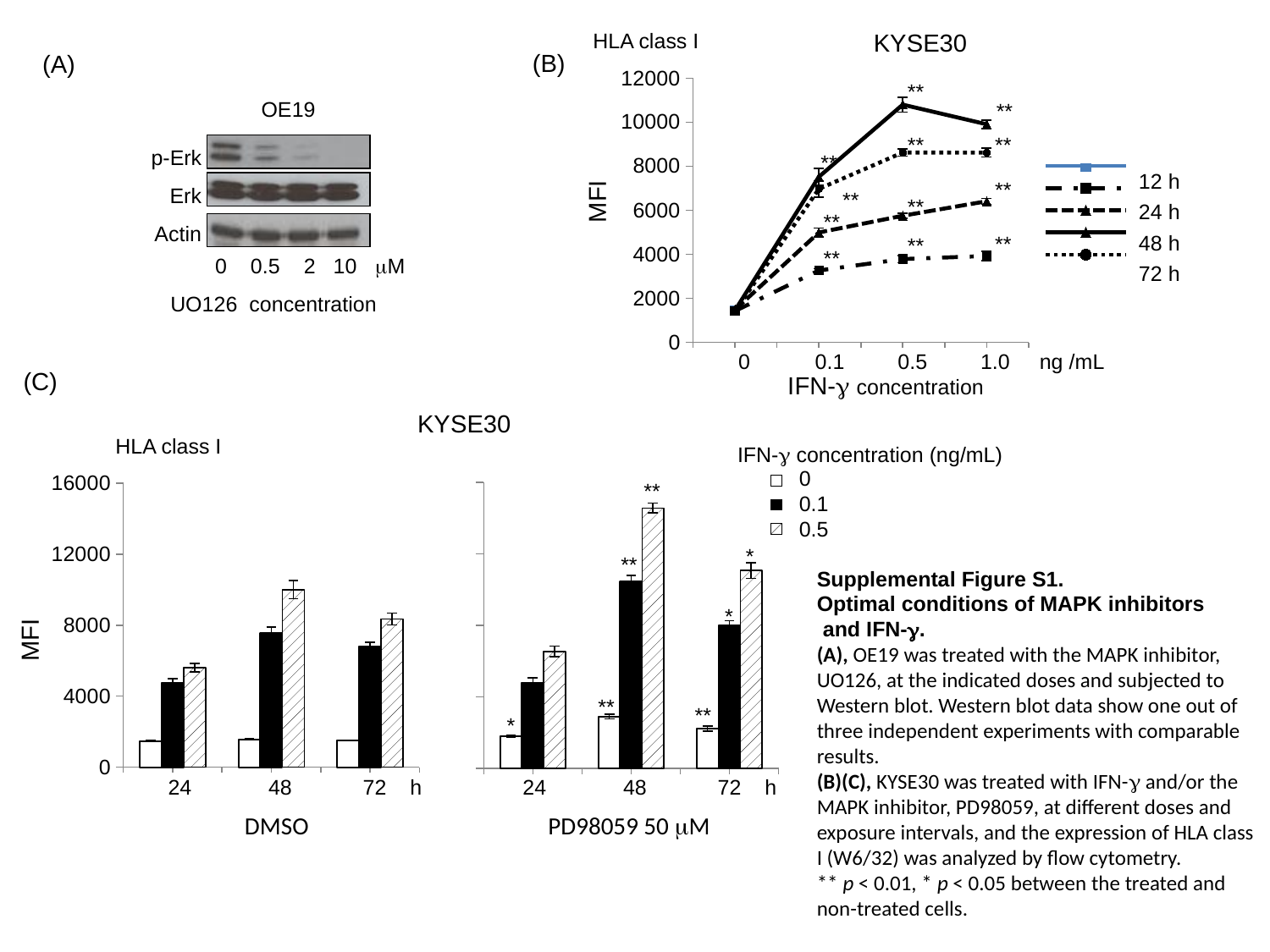
What kind of chart is used in panel (C) for the DMSO and PD98059 50 µM data? bar chart In chart (B), is the MFI for the 12 h series at 1.0 ng/mL greater or less than 6000? less In the PD98059 50 µM bar chart in panel (C), how many IFN-γ concentration series does the legend list? 3 In chart (B), how many IFN-γ concentration points are plotted along the x axis? 4 In chart (B), which series has the lowest MFI at 1.0 ng/mL IFN-γ? 12 h In chart (B), is the MFI for the 48 h series at 0.5 ng/mL greater or less than 10000? greater In chart (B), how many series does the legend list? 5 What kind of chart is chart (B), titled KYSE30 with IFN-γ concentration on the x axis? line chart In the PD98059 50 µM bar chart in panel (C), is the MFI for 0.5 ng/mL IFN-γ at 48 h greater or less than 12000? greater In chart (B), does the MFI of the 24 h series rise or fall as IFN-γ concentration increases from 0 to 1.0 ng/mL? rise In chart (B), which series has the highest MFI at 0.5 ng/mL IFN-γ? 48 h In the DMSO bar chart in panel (C), which IFN-γ concentration gives the highest MFI at 48 h? 0.5